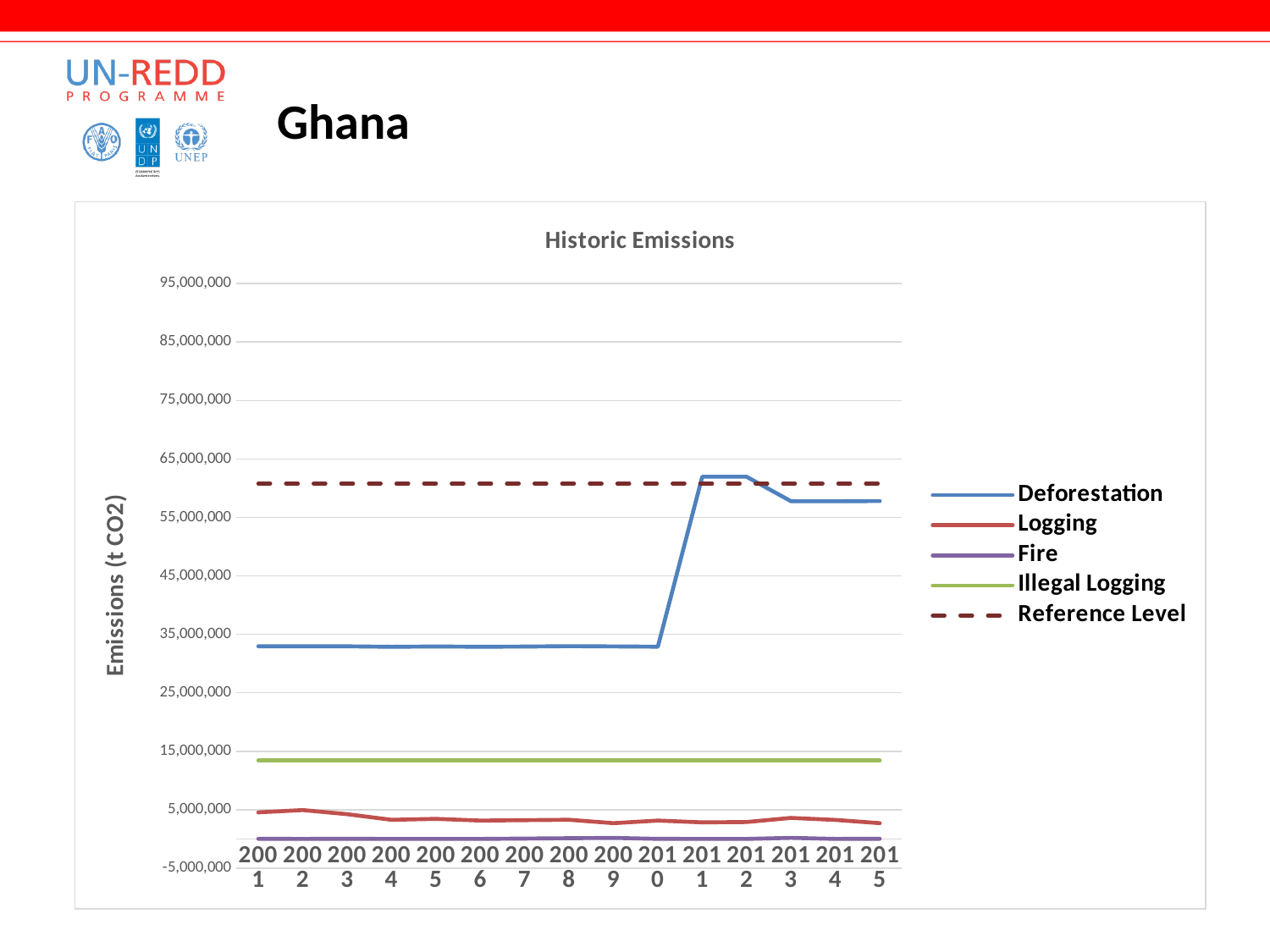
How many years are shown on the x axis of the Historic Emissions chart? 15 Which legend entry on the Historic Emissions chart is drawn as a dashed line? Reference Level In 2008, which is larger: Deforestation or Illegal Logging? Deforestation Is the Deforestation value for 2005 greater or less than 35,000,000? less Which series has the highest value in 2005 on the Historic Emissions chart? Reference Level Does the Deforestation series rise or fall between 2010 and 2011? rise Is the Deforestation value for 2014 greater or less than 55,000,000? greater Which series has the lowest value in 2007 on the Historic Emissions chart? Fire How many series does the legend of the Historic Emissions chart list? 5 What kind of chart is the Historic Emissions chart? line chart Is the Illegal Logging value for 2010 greater or less than 15,000,000? less